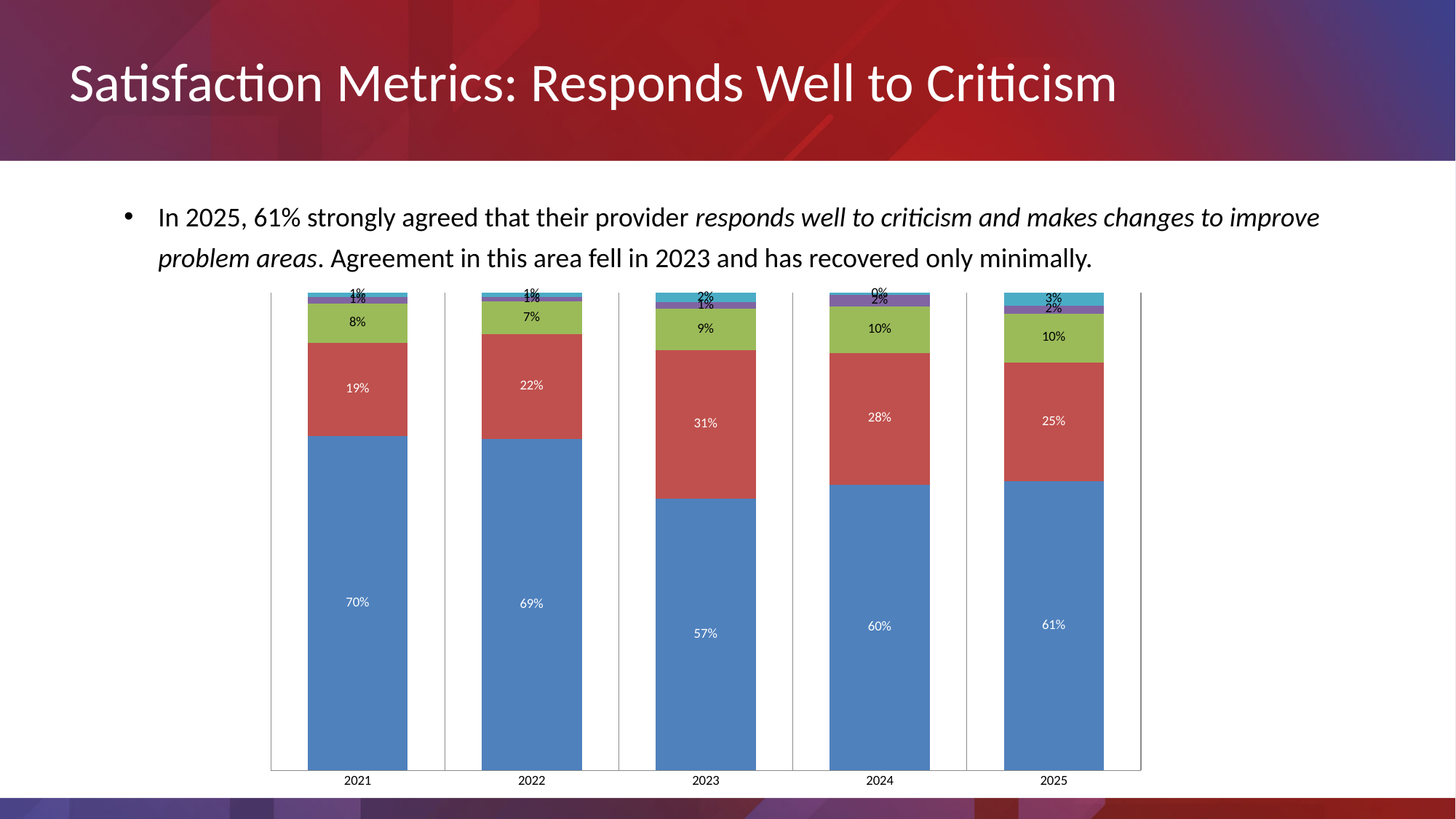
What is the value of the green segment for 2022? 7% What is the value of the blue (bottom) segment for 2025? 61% Which year has the highest value for the blue (bottom) segment? 2021 Which is larger, the red segment for 2022 or the red segment for 2024? 2024 What type of chart is shown on the slide? stacked bar chart What is the value of the red segment for 2023? 31% How many years are shown along the x axis of the chart? 5 Which year has the highest value for the red segment? 2023 Does the blue (bottom) segment rise or fall from 2021 to 2023? fall Which year has the lowest value for the blue (bottom) segment? 2023 What is the difference between the blue (bottom) segment values for 2021 and 2023? 13% What is the value of the topmost (cyan) segment for 2025? 3%